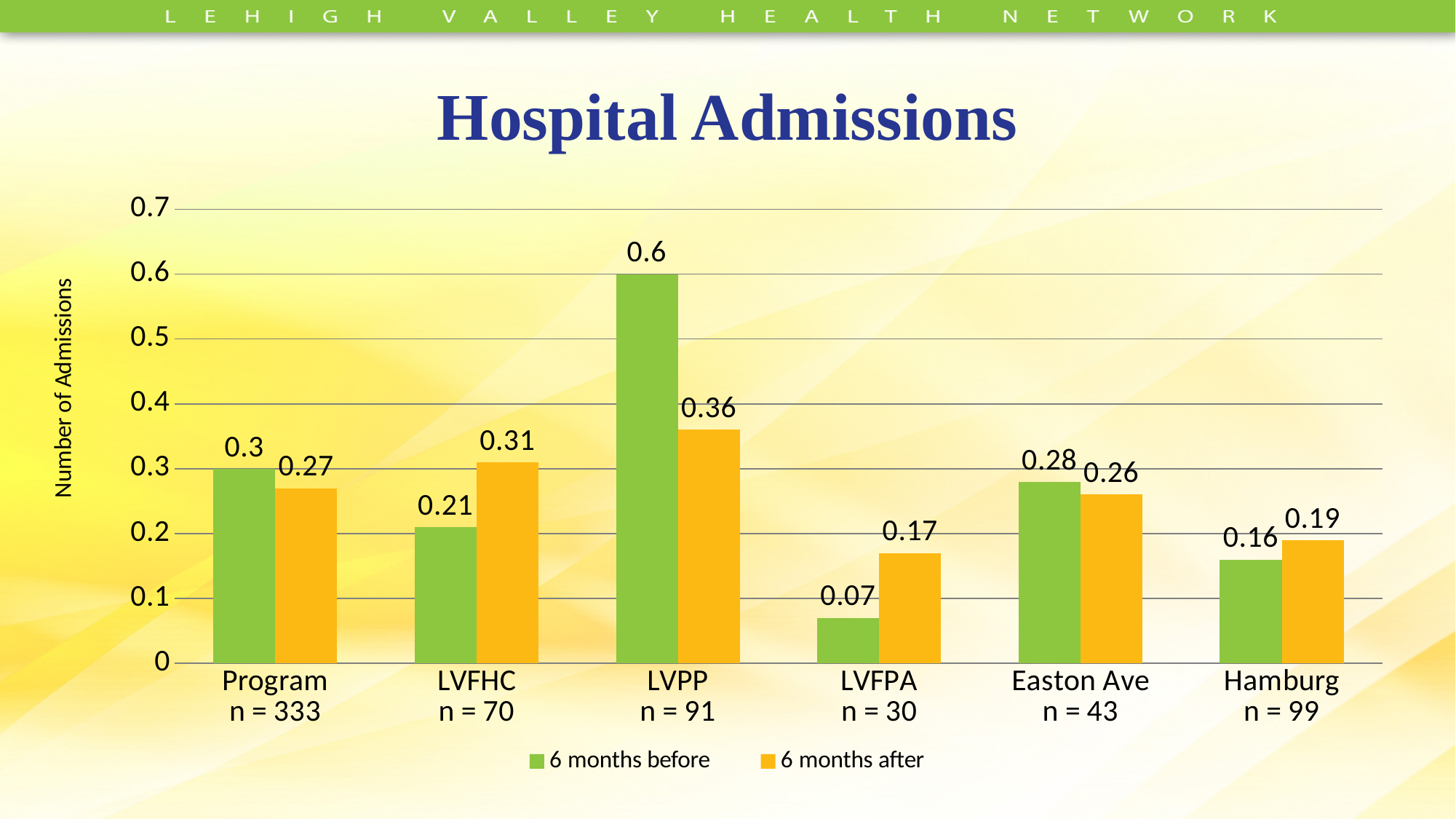
How many series does the legend list? 2 What is the difference between the 6 months before and 6 months after values for LVPP? 0.24 Which category has the highest value in the 6 months before series? LVPP What is the value for Hamburg in the 6 months after series? 0.19 For LVFHC, which is larger: the 6 months before value or the 6 months after value? 6 months after How many categories are shown on the x axis? 6 What is the value for LVFPA in the 6 months before series? 0.07 What kind of chart is shown on the slide? bar chart What is the title of the chart? Hospital Admissions What is the value for LVPP in the 6 months before series? 0.6 Which category has the lowest value in the 6 months after series? LVFPA Is the 6 months after value for Easton Ave greater or less than 0.3? less